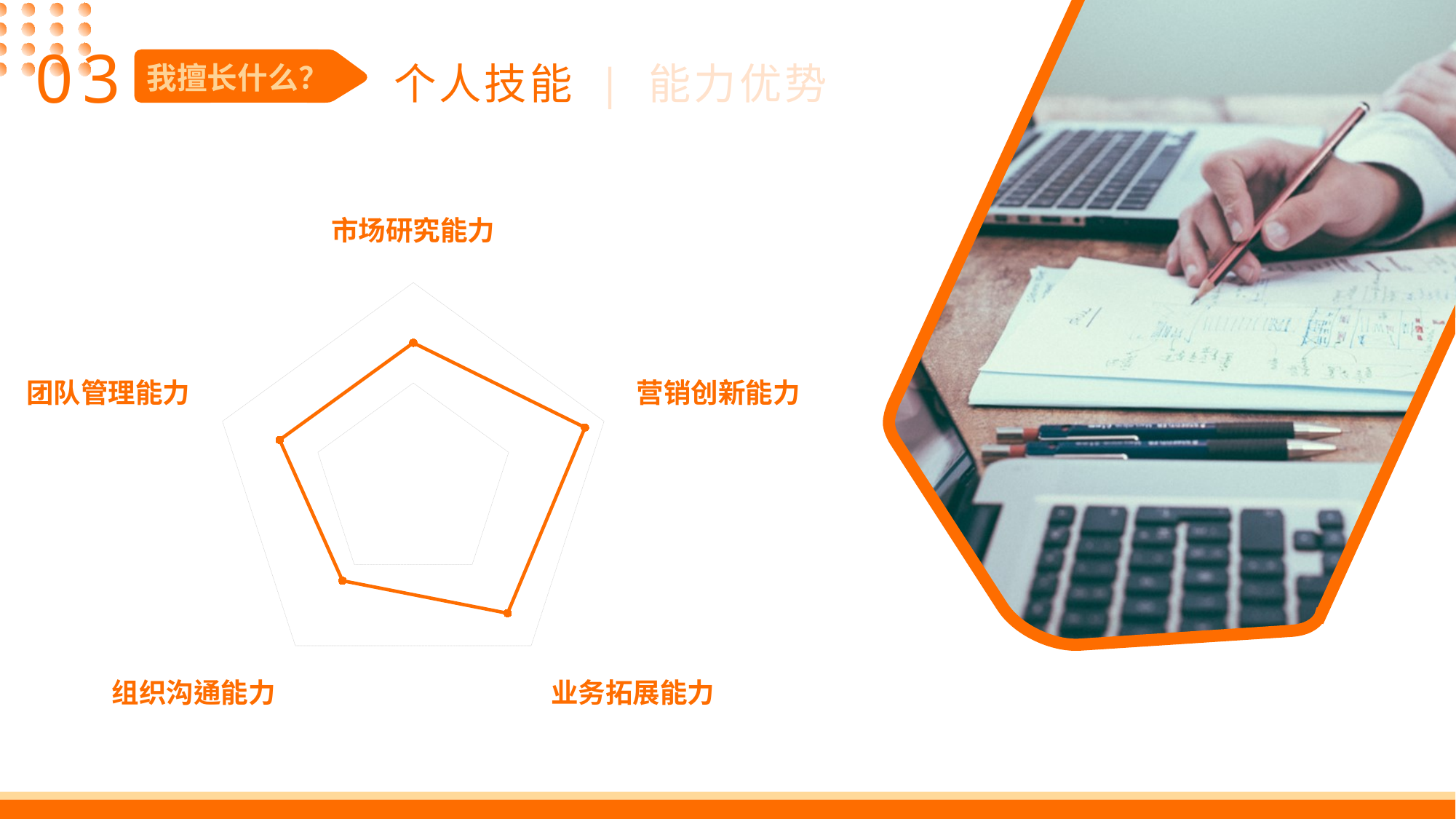
What kind of chart is shown on the slide? radar chart What colour is the data line on the radar chart? orange How many data series are plotted on the radar chart? 1 Which is larger on the radar chart, 营销创新能力 or 组织沟通能力? 营销创新能力 Which skill has the lowest value on the radar chart? 组织沟通能力 Which skill label appears at the top vertex of the radar chart? 市场研究能力 Which is larger on the radar chart, 营销创新能力 or 团队管理能力? 营销创新能力 How many categories (skills) does the radar chart have? 5 Which is larger on the radar chart, 业务拓展能力 or 组织沟通能力? 业务拓展能力 Which skill has the highest value on the radar chart? 营销创新能力